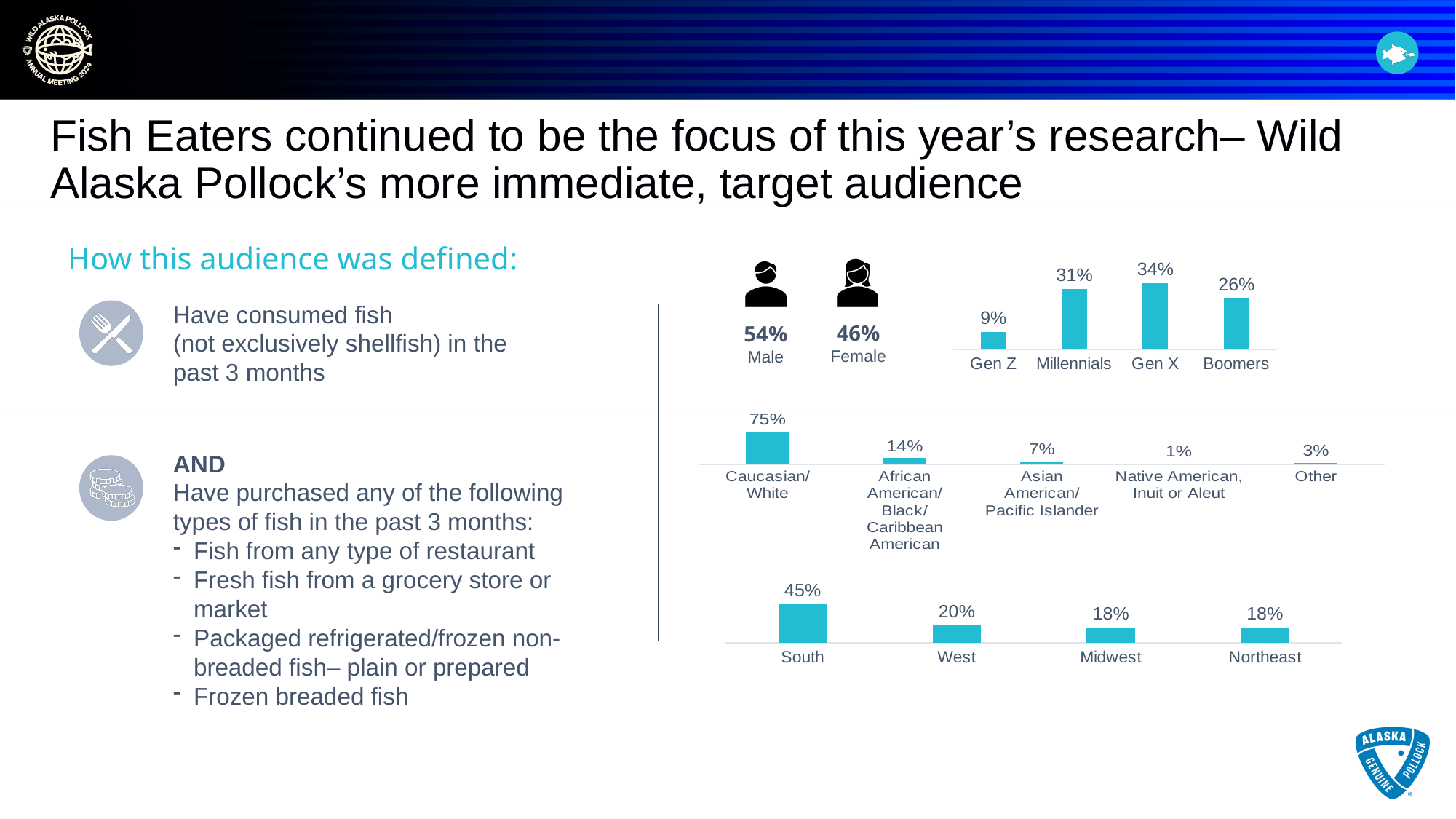
In the ethnicity bar chart in the middle of the slide, which category has the lowest value? Native American, Inuit or Aleut In the region bar chart at the bottom of the slide, what is the difference between South and West? 25% What type of chart is used for the region data at the bottom of the slide? Bar chart In the ethnicity bar chart in the middle of the slide, how many categories are shown? 5 In the generation bar chart at the top right, how many generation categories are shown? 4 In the generation bar chart at the top right, which generation has the highest value? Gen X In the generation bar chart at the top right, what is the difference between Gen X and Boomers? 8% In the region bar chart at the bottom of the slide, what is the value for South? 45% In the ethnicity bar chart in the middle of the slide, which is larger: African American/Black/Caribbean American or Asian American/Pacific Islander? African American/Black/Caribbean American In the ethnicity bar chart in the middle of the slide, what is the value for Caucasian/White? 75% In the generation bar chart at the top right, what is the value for Millennials? 31% In the generation bar chart at the top right, which generation has the lowest value? Gen Z